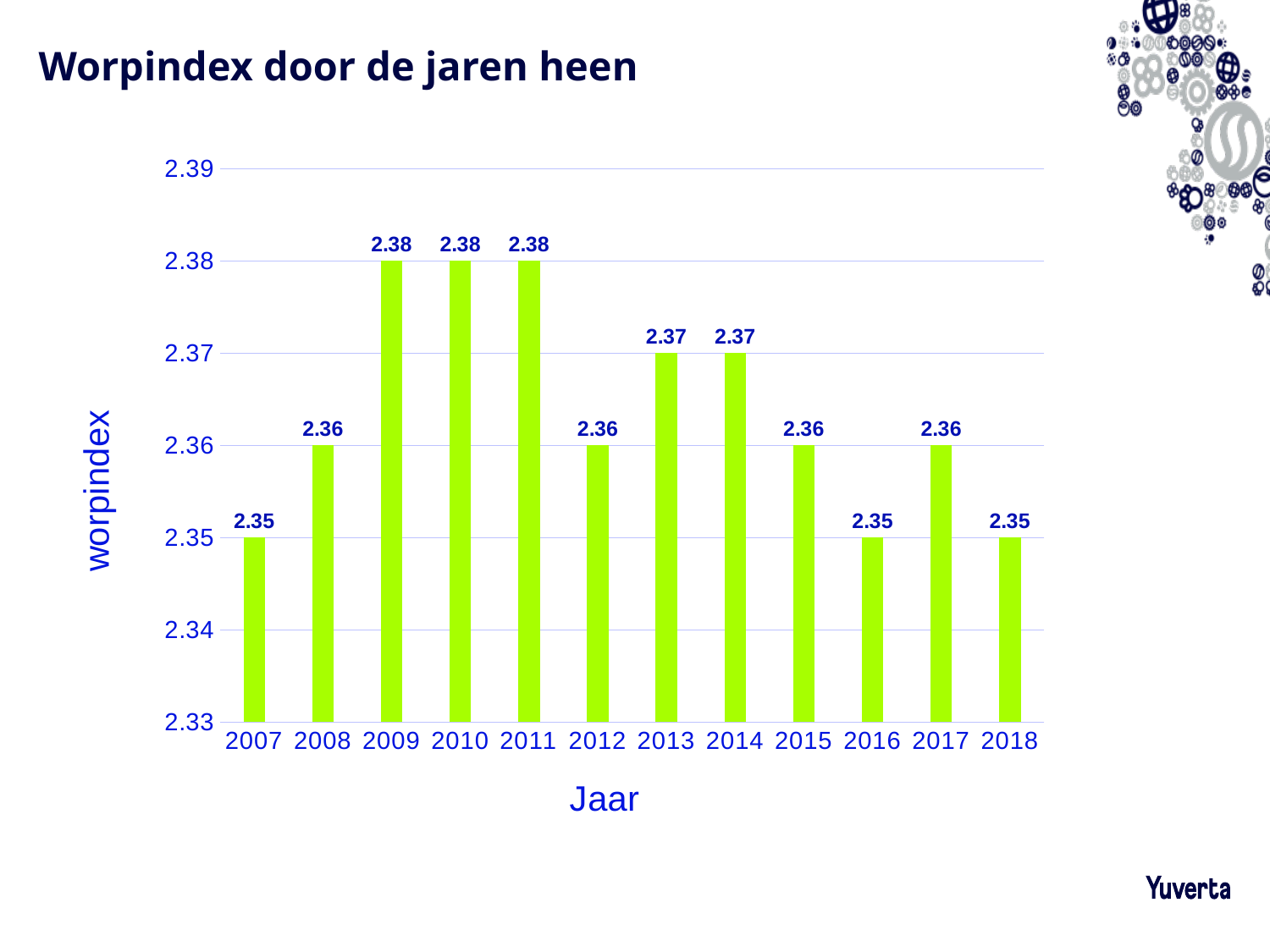
What is the worpindex value for 2017? 2.36 Is the worpindex value for 2010 greater or less than 2.37? greater Which is larger, the worpindex value for 2014 or for 2015? 2014 What is the label of the x axis of the chart? Jaar What kind of chart is shown on the slide? bar chart What is the difference between the worpindex values for 2011 and 2018? 0.03 What is the worpindex value for 2009? 2.38 Do the worpindex values rise or fall from 2011 to 2012? fall What is the worpindex value for 2016? 2.35 How many years are shown on the x axis of the chart? 12 What is the worpindex value for 2013? 2.37 What is the label of the y axis of the chart? worpindex